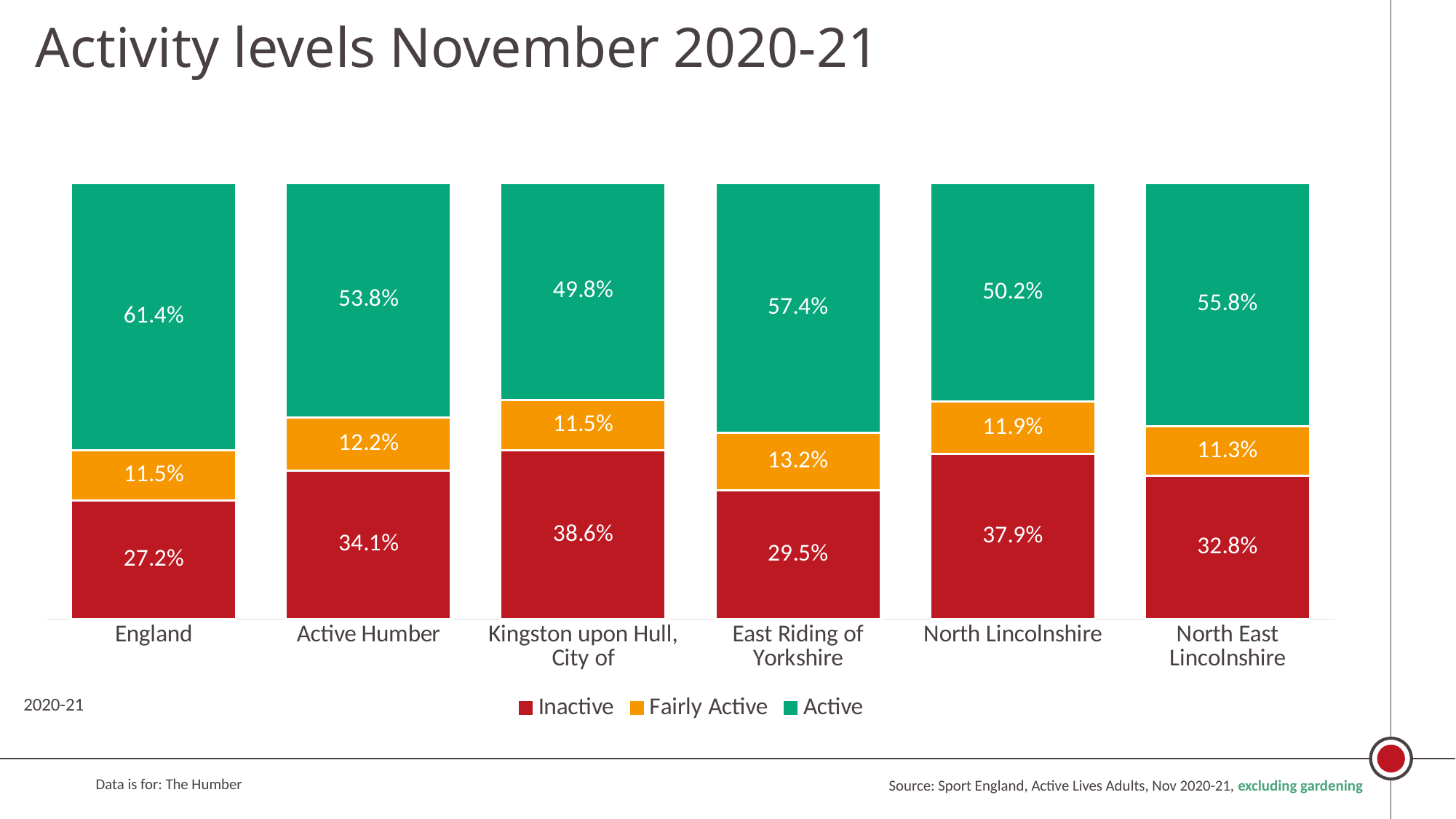
What is the difference in Active percentage between England and Kingston upon Hull, City of? 11.6 percentage points Which has a larger Inactive percentage, Active Humber or North Lincolnshire? North Lincolnshire How many areas are shown on the x axis? 6 Which area has the highest Active percentage? England What is the Fairly Active percentage for East Riding of Yorkshire? 13.2% What is the Inactive percentage for Kingston upon Hull, City of? 38.6% What type of chart is shown on the slide? Stacked bar chart What is the Active percentage for North East Lincolnshire? 55.8% How many series does the legend list? 3 Which area has the lowest Active percentage? Kingston upon Hull, City of What is the Active percentage for England? 61.4% Which area has the highest Fairly Active percentage? East Riding of Yorkshire